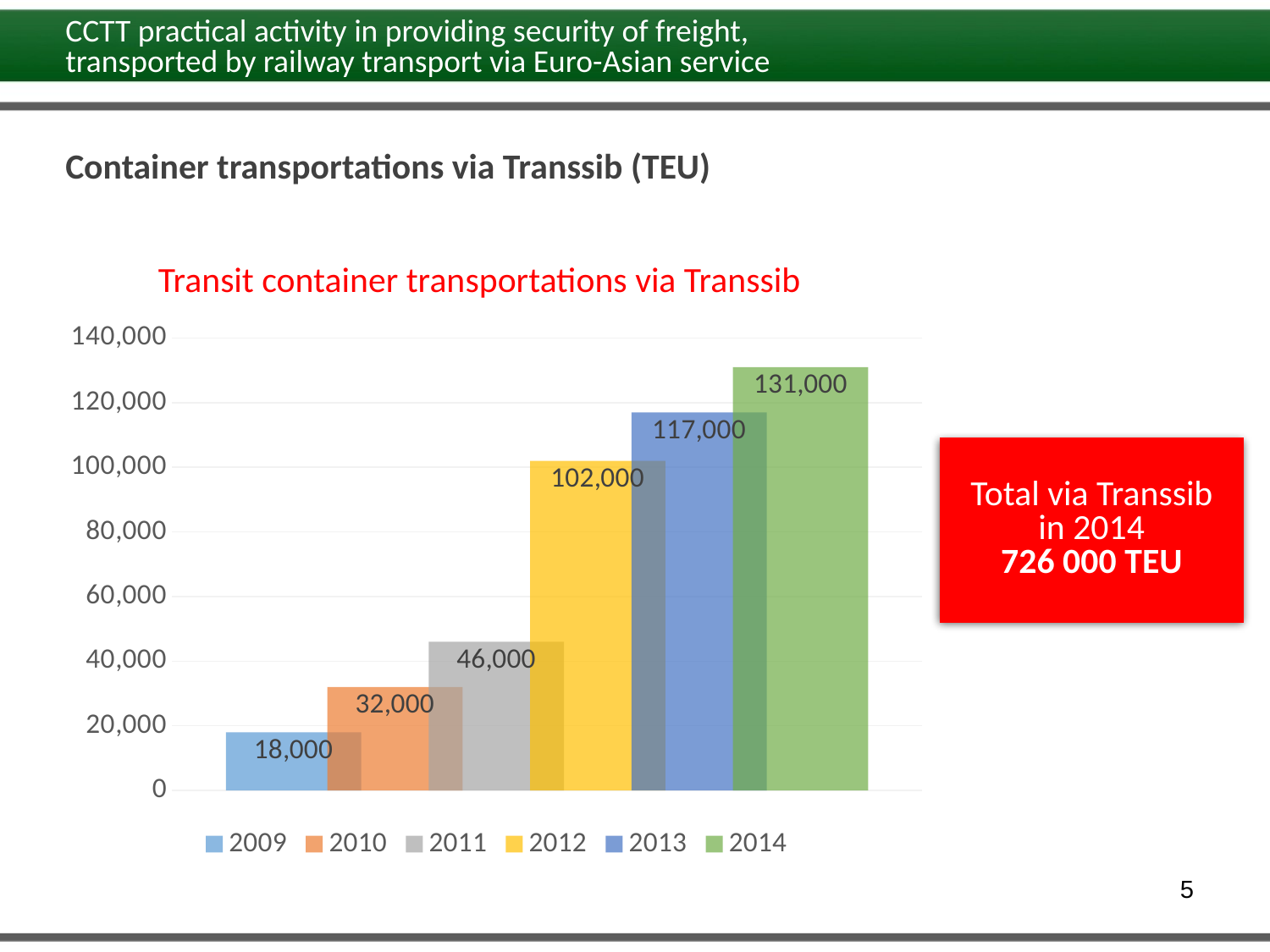
What kind of chart is shown? bar chart Which year has the highest value? 2014 Which is larger, the value for 2012 or the value for 2011? 2012 What is the value for 2014? 131,000 What is the difference between the values for 2011 and 2010? 14,000 How many years are plotted in the chart? 6 What is the difference between the values for 2014 and 2013? 14,000 Which year has the lowest value? 2009 What is the value for 2009? 18,000 Do the values rise or fall from 2009 to 2014? rise What is the value for 2012? 102,000 Is the value for 2013 greater or less than 100,000? greater